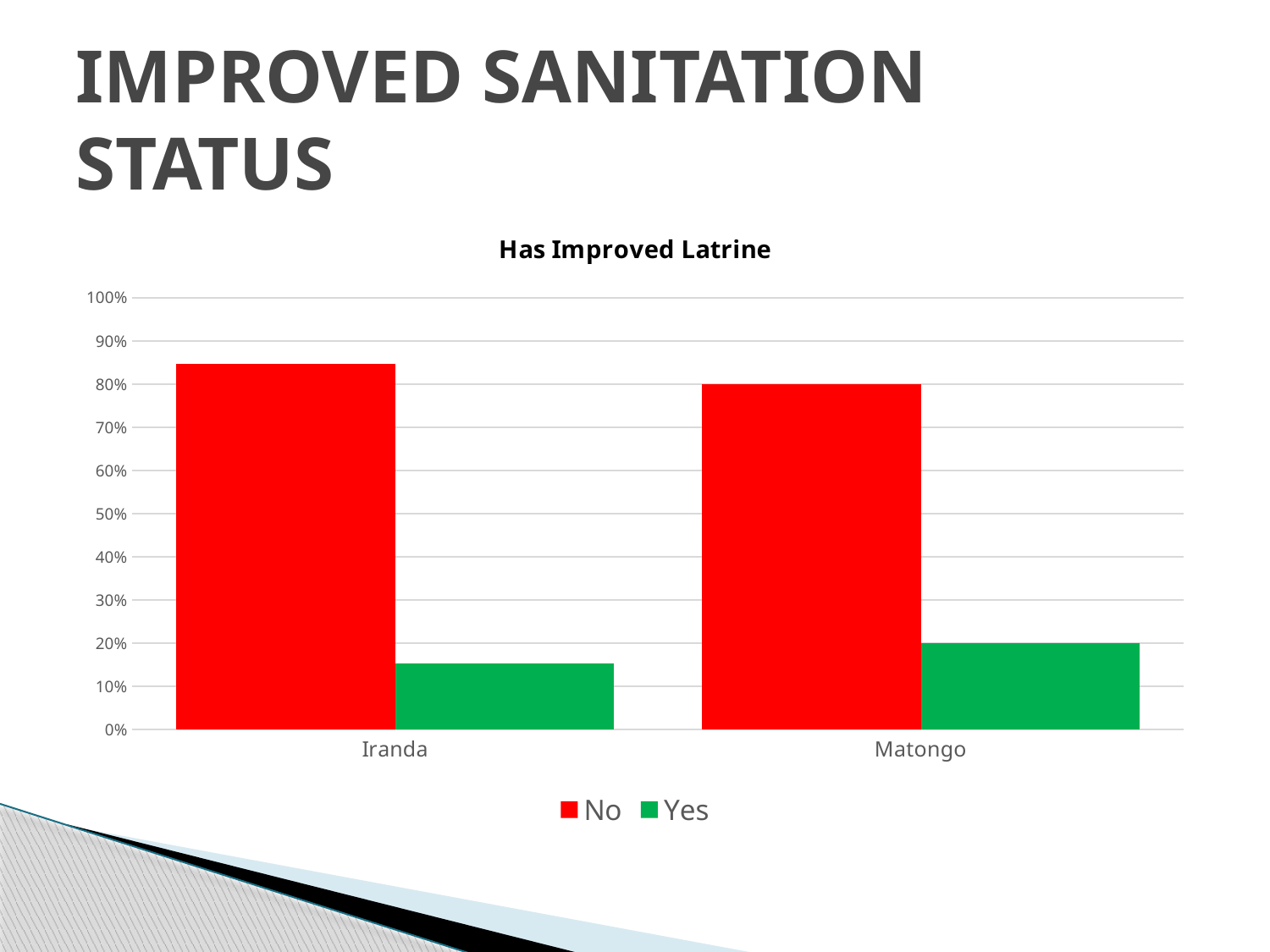
Which colour represents the Yes series? green What is the title of the chart? Has Improved Latrine How many categories are shown on the x axis? 2 What kind of chart is shown on the slide? bar chart Which category has the higher Yes value, Iranda or Matongo? Matongo What is the value of the Yes bar for Matongo? 20% What is the value of the No bar for Matongo? 80% Is the value of the No bar for Iranda greater or less than 80%? greater Which category has the higher No value, Iranda or Matongo? Iranda What is the difference between the No and Yes values for Matongo? 60% How many series does the legend list? 2 Is the value of the Yes bar for Iranda greater or less than 20%? less